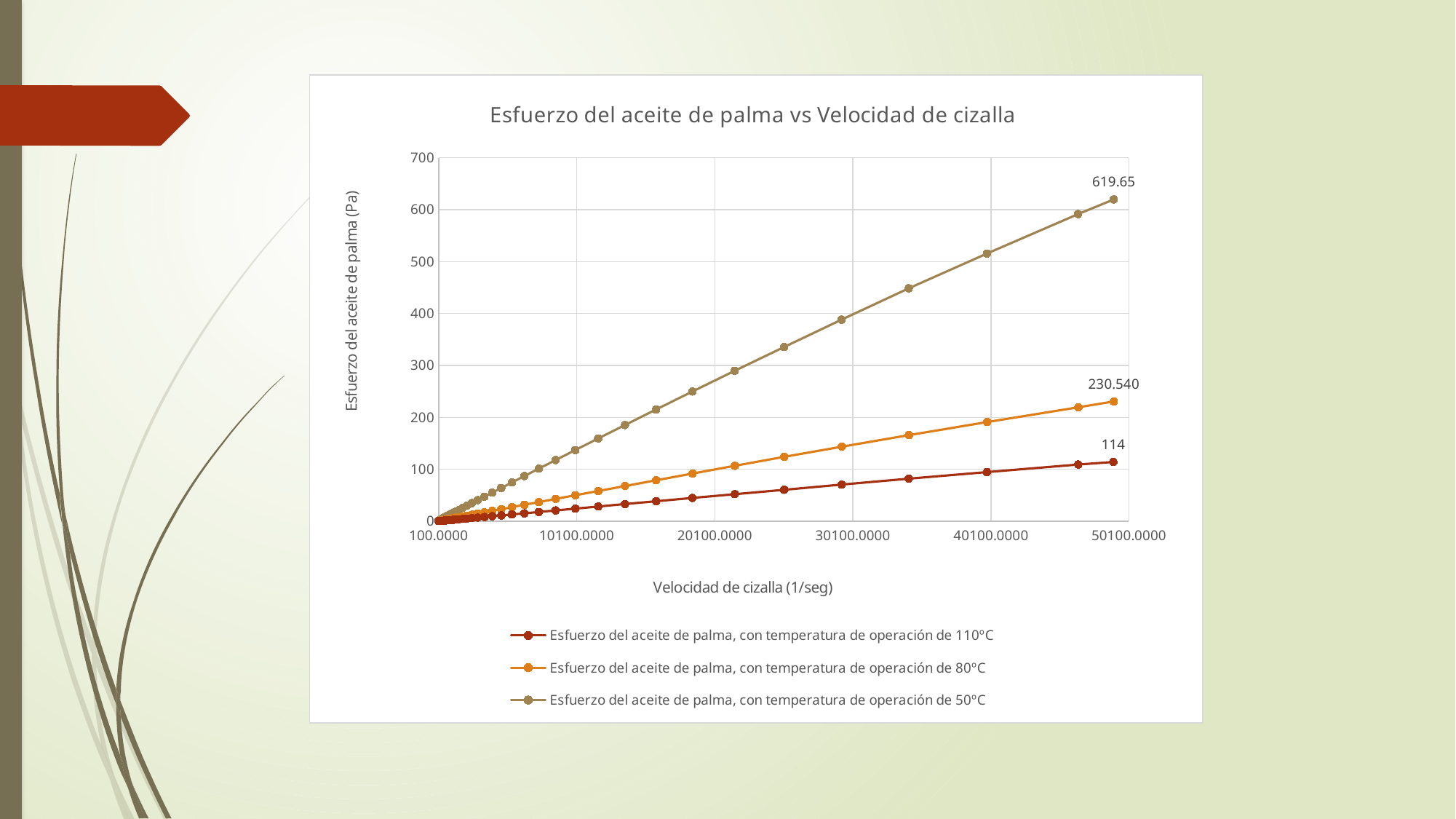
What kind of chart is shown on the slide? Line chart What is the labelled final value of the series for an operating temperature of 110°C? 114 How many series does the legend list? 3 What is the difference between the labelled final values of the 50°C series and the 80°C series? 389.11 Which series has the lowest value at the right end of the chart? Esfuerzo del aceite de palma, con temperatura de operación de 110°C Is the value of the 50°C series at a shear rate of 30100.0000 greater or less than 300? greater What is the title of the chart? Esfuerzo del aceite de palma vs Velocidad de cizalla What is the labelled final value of the series for an operating temperature of 50°C? 619.65 Do the values of each series rise or fall as the shear rate increases along the x axis? Rise Which series reaches the highest value at the right end of the chart? Esfuerzo del aceite de palma, con temperatura de operación de 50°C What is the labelled final value of the series for an operating temperature of 80°C? 230.540 Is the labelled final value of the 80°C series larger or smaller than that of the 110°C series? Larger